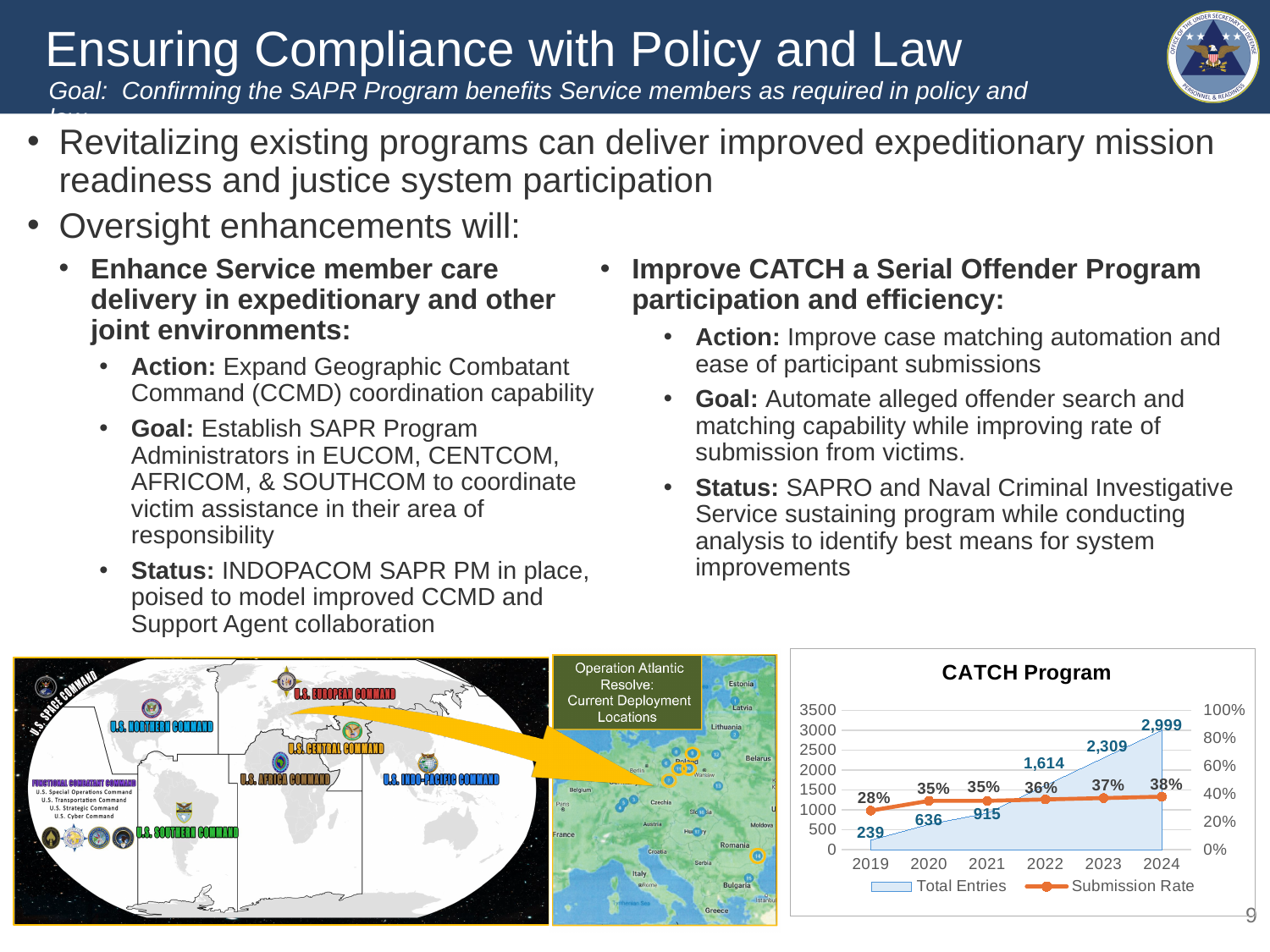
In the CATCH Program chart, what is the difference in Total Entries between 2024 and 2023? 690 In the CATCH Program chart, which is larger, Total Entries in 2021 or in 2020? 2021 In the CATCH Program chart, what is the Submission Rate for 2023? 37% How many series does the legend of the CATCH Program chart list? 2 In the CATCH Program chart, do Total Entries rise or fall from 2019 to 2024? rise How many years are shown on the x axis of the CATCH Program chart? 6 In the CATCH Program chart, which year has the highest Submission Rate? 2024 In the CATCH Program chart, what is the value of Total Entries for 2024? 2,999 In the CATCH Program chart, what is the Submission Rate for 2019? 28% In the CATCH Program chart, what is the value of Total Entries for 2022? 1,614 In the CATCH Program chart, which year has the lowest Total Entries? 2019 In the CATCH Program chart, what is the difference in Submission Rate between 2020 and 2019? 7%